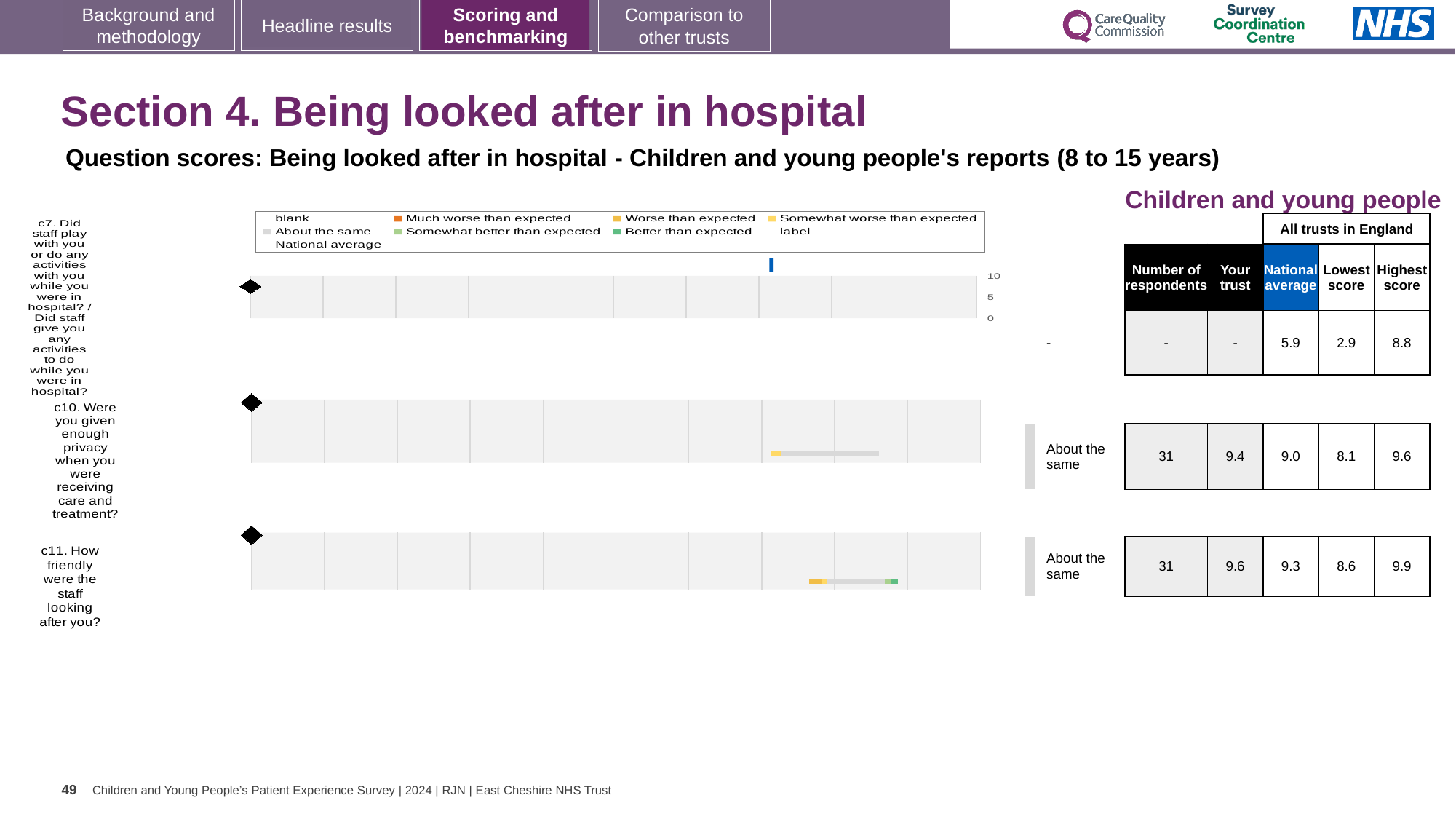
How many survey questions are plotted as rows in the chart? 3 What is the maximum value shown on the chart's score axis? 10 Is the plotted 'Your trust' value for c11 greater or less than 5? greater How many respondents answered c10? 31 What is the highest score across all trusts in England for c7? 8.8 What is the 'Your trust' score for c10 (Were you given enough privacy when you were receiving care and treatment?)? 9.4 What is the national average score for c7 (Did staff play with you or do any activities with you while you were in hospital?)? 5.9 What is the 'Your trust' score for c11 (How friendly were the staff looking after you?)? 9.6 In the chart legend, what colour represents 'Better than expected'? Green What is the difference between the 'Your trust' score and the national average for c11? 0.3 Which question has the highest 'Your trust' score? c11 For c10, which is larger: the 'Your trust' score or the national average? Your trust